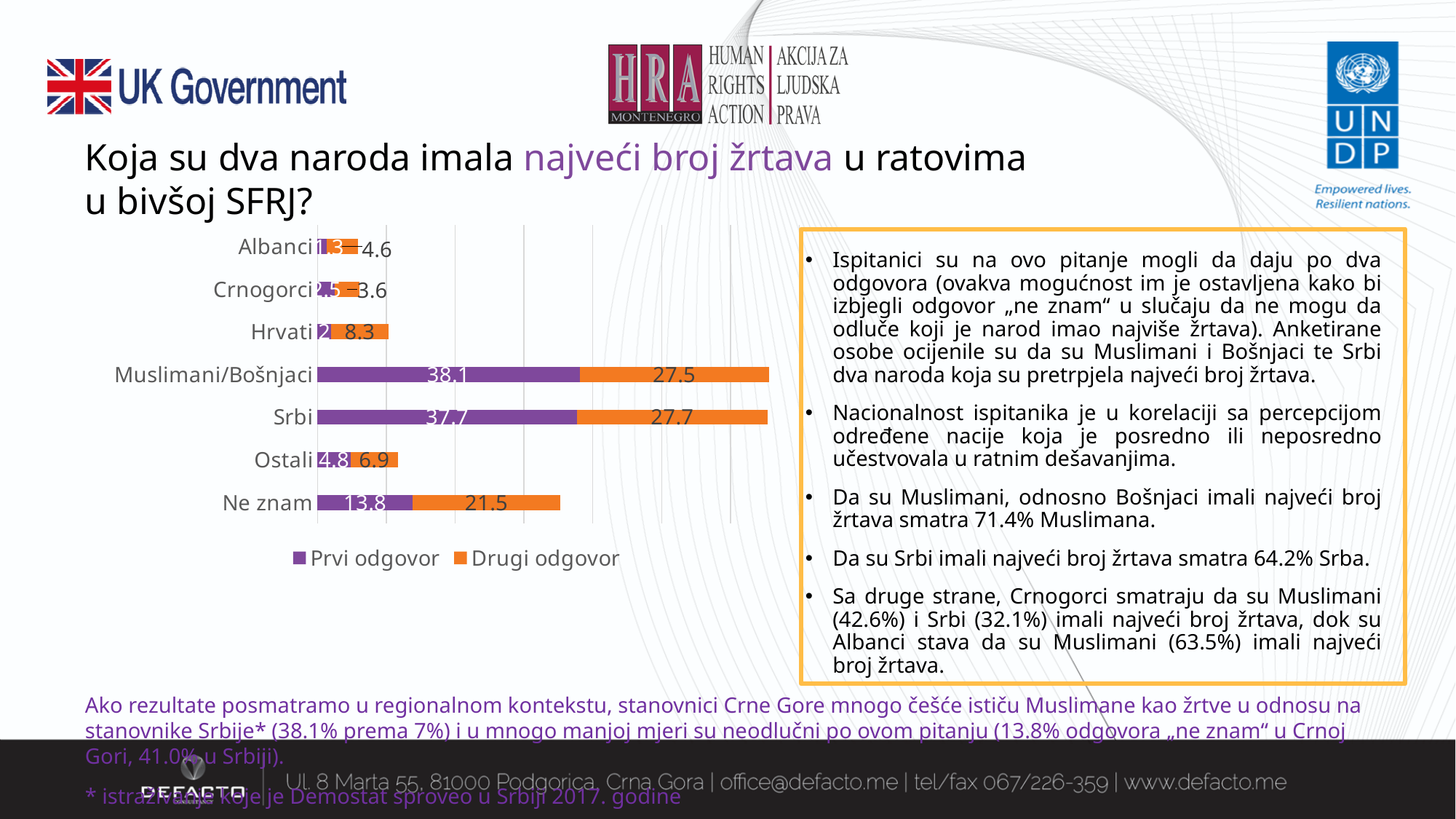
How many categories are shown on the chart? 7 Which category has the highest Prvi odgovor value? Muslimani/Bošnjaci What is the difference between the Prvi odgovor values for Muslimani/Bošnjaci and Srbi? 0.4 What is the total of the stacked bar for Srbi? 65.4 What kind of chart is shown on the slide? bar chart What is the Drugi odgovor value for Hrvati? 8.3 What is the Drugi odgovor value for Srbi? 27.7 What is the Prvi odgovor value for Muslimani/Bošnjaci? 38.1 What is the Prvi odgovor value for Ne znam? 13.8 Which has the larger Drugi odgovor value, Hrvati or Ostali? Hrvati How many series does the chart legend list? 2 What is the Drugi odgovor value for Ne znam? 21.5